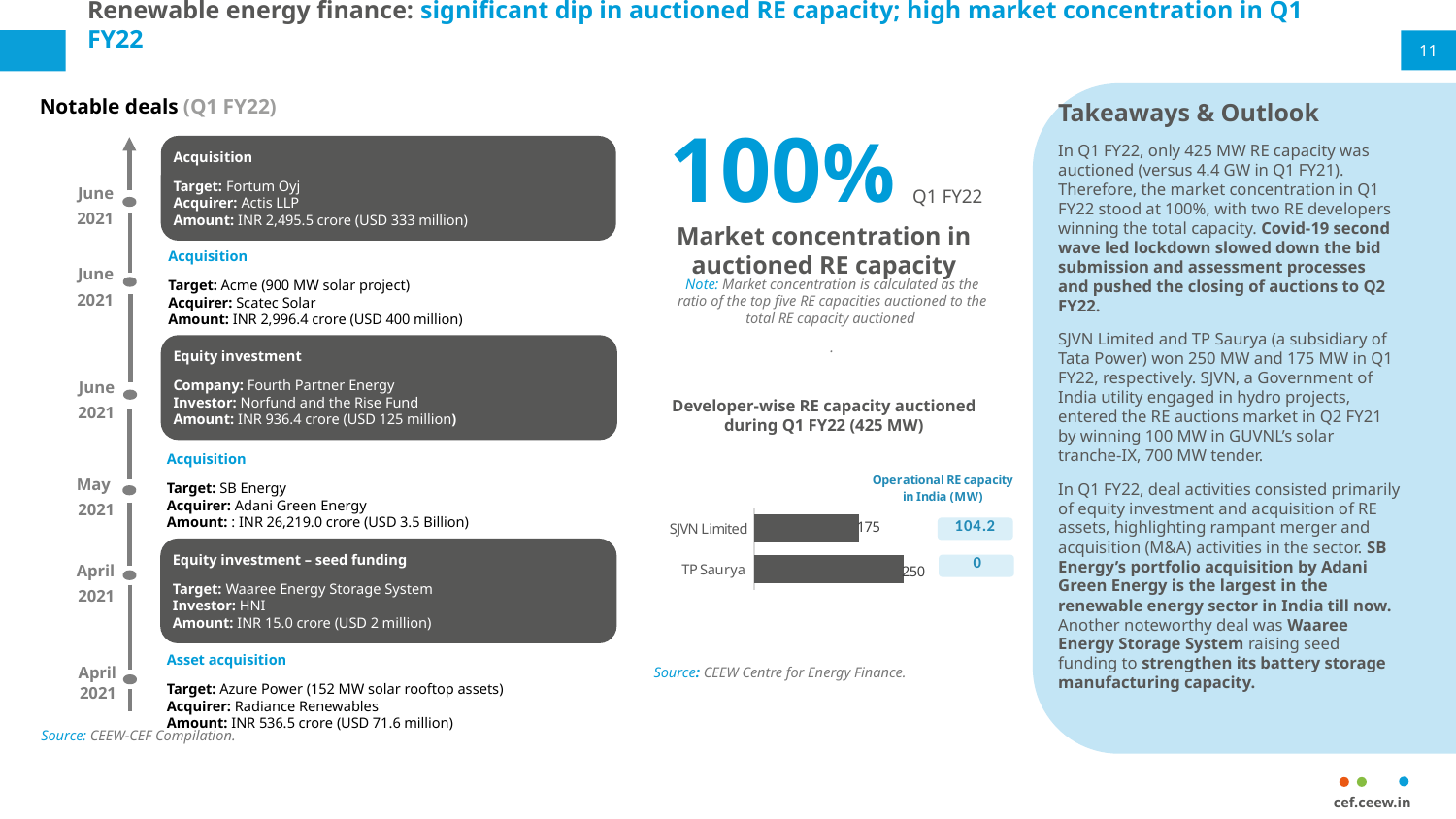
In the chart 'Developer-wise RE capacity auctioned during Q1 FY22 (425 MW)', what is the value for TP Saurya? 250 In the chart 'Developer-wise RE capacity auctioned during Q1 FY22 (425 MW)', which developer has the highest auctioned capacity? TP Saurya How many developers are shown in the chart 'Developer-wise RE capacity auctioned during Q1 FY22 (425 MW)'? 2 What total capacity is stated in the title of the chart 'Developer-wise RE capacity auctioned during Q1 FY22'? 425 MW In the chart 'Developer-wise RE capacity auctioned during Q1 FY22 (425 MW)', which developer has the lowest auctioned capacity? SJVN Limited In the chart 'Developer-wise RE capacity auctioned during Q1 FY22 (425 MW)', what is the total of the two developers' values? 425 Next to the chart 'Developer-wise RE capacity auctioned during Q1 FY22 (425 MW)', what operational RE capacity in India (MW) is listed for SJVN Limited? 104.2 What kind of chart is 'Developer-wise RE capacity auctioned during Q1 FY22 (425 MW)'? bar chart In the chart 'Developer-wise RE capacity auctioned during Q1 FY22 (425 MW)', what is the difference between the values for TP Saurya and SJVN Limited? 75 In the chart 'Developer-wise RE capacity auctioned during Q1 FY22 (425 MW)', which is larger: the value for SJVN Limited or the value for TP Saurya? TP Saurya In the chart 'Developer-wise RE capacity auctioned during Q1 FY22 (425 MW)', what is the value for SJVN Limited? 175